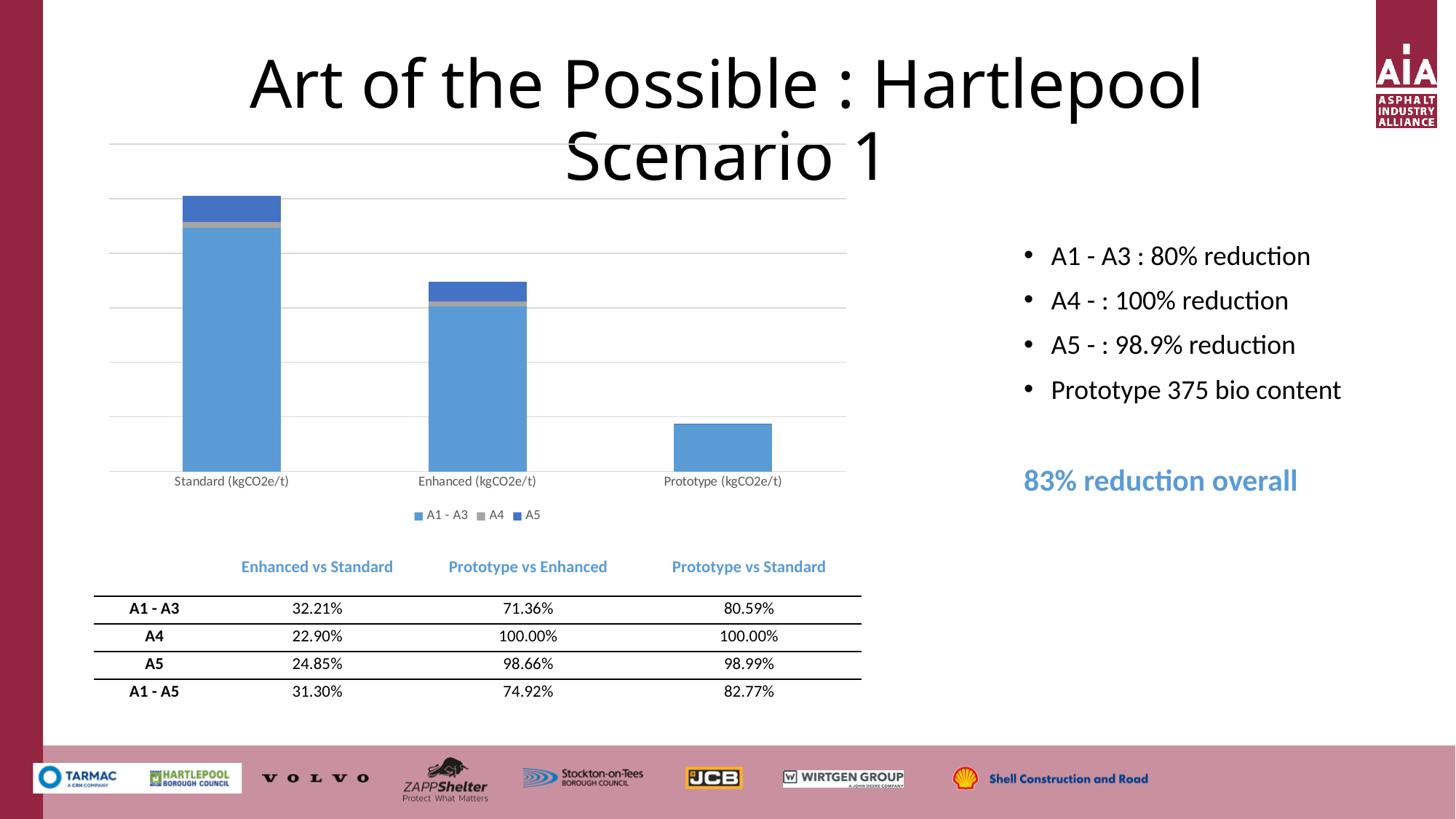
Which category's bar consists of only the A1 - A3 series with no visible A4 or A5 segment? Prototype (kgCO2e/t) What are the three series names listed in the chart legend? A1 - A3, A4, A5 How many categories are shown on the x axis of the chart? 3 Which category has the shortest stacked bar? Prototype (kgCO2e/t) What kind of chart is shown on the slide? stacked bar chart How many series does the chart legend list? 3 Which series is shown in the lightest blue at the bottom of each stacked bar? A1 - A3 Which category has the tallest stacked bar? Standard (kgCO2e/t) Which is larger, the total bar for Enhanced (kgCO2e/t) or for Prototype (kgCO2e/t)? Enhanced (kgCO2e/t) Which is larger, the total bar for Standard (kgCO2e/t) or for Enhanced (kgCO2e/t)? Standard (kgCO2e/t) Do the bar totals rise or fall from left to right across the x axis? fall